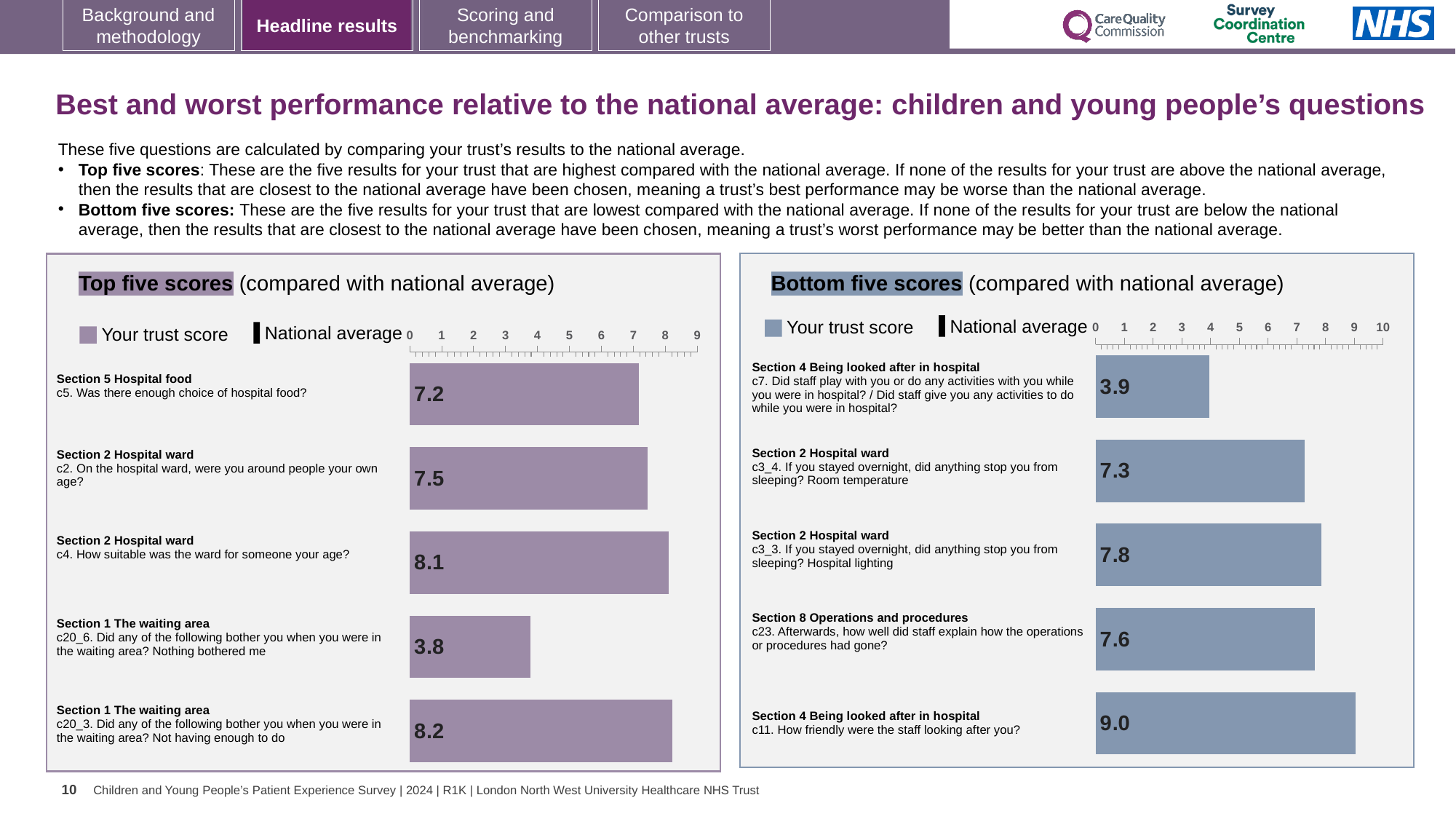
In the Top five scores chart, what is the trust score for c5 (Was there enough choice of hospital food?)? 7.2 How many series does the legend of the Bottom five scores chart list? 2 What type of chart is the Top five scores chart? Bar chart In the Bottom five scores chart, what is the difference between the trust scores for c3_3 (Hospital lighting) and c3_4 (Room temperature)? 0.5 In the Top five scores chart, which has the larger trust score: c2 (around people your own age) or c4 (how suitable was the ward)? c4 In the Bottom five scores chart, what is the difference between the trust scores for c11 and c7? 5.1 In the Bottom five scores chart, which question has the lowest trust score? c7. Did staff play with you or do any activities with you In the Top five scores chart, which question has the highest trust score? c20_3. Not having enough to do In the Top five scores chart, which question has the lowest trust score? c20_6. Nothing bothered me In the Bottom five scores chart, what is the trust score for c11 (How friendly were the staff looking after you?)? 9.0 In the Bottom five scores chart, is the trust score for c3_3 (Hospital lighting) greater or less than 7? greater How many questions are plotted in the Top five scores chart? 5